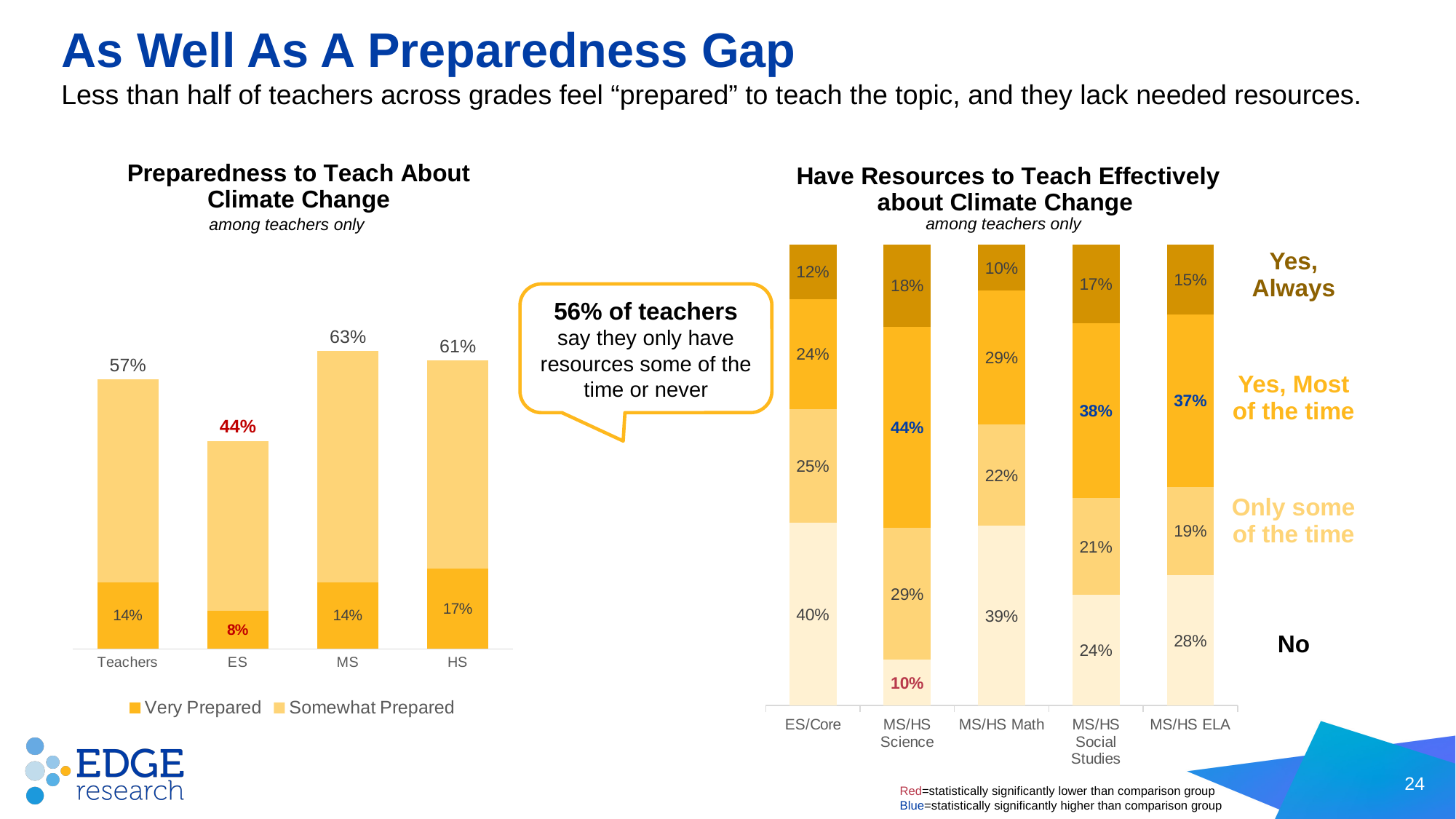
In the 'Preparedness to Teach About Climate Change' chart, how many series does the legend list? 2 What kind of chart is the 'Have Resources to Teach Effectively about Climate Change' chart? Stacked bar chart In the 'Preparedness to Teach About Climate Change' chart, what is the total value shown above the MS bar? 63% In the 'Have Resources to Teach Effectively about Climate Change' chart, what is the difference between the 'No' values for MS/HS Math and MS/HS Science? 29 percentage points In the 'Preparedness to Teach About Climate Change' chart, what percentage of HS teachers are Very Prepared? 17% In the 'Preparedness to Teach About Climate Change' chart, what is the difference between the Very Prepared values for HS and ES? 9 percentage points In the 'Have Resources to Teach Effectively about Climate Change' chart, which has the larger 'Only some of the time' value, ES/Core or MS/HS ELA? ES/Core In the 'Have Resources to Teach Effectively about Climate Change' chart, what percentage of ES/Core teachers answered 'No'? 40% In the 'Have Resources to Teach Effectively about Climate Change' chart, what is the 'Yes, Always' value for MS/HS Science? 18% In the 'Have Resources to Teach Effectively about Climate Change' chart, which category has the highest 'Yes, Most of the time' value? MS/HS Science In the 'Preparedness to Teach About Climate Change' chart, which category has the lowest Very Prepared value? ES In the 'Preparedness to Teach About Climate Change' chart, how many categories are shown on the x axis? 4